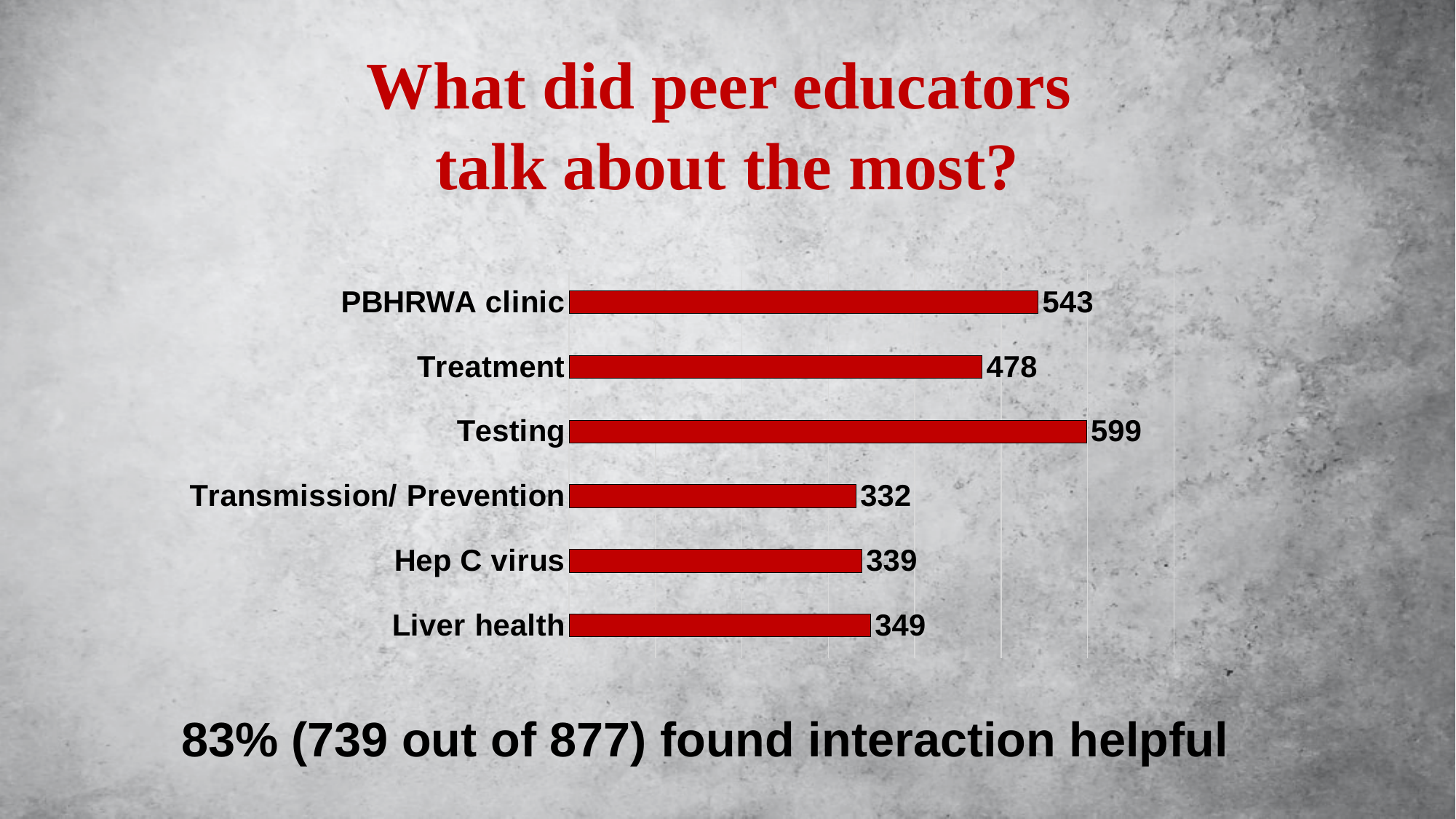
What is the difference between the values for Testing and Treatment? 121 How many categories are shown in the chart? 6 What is the value for Testing? 599 What is the difference between the values for Liver health and Hep C virus? 10 What is the value for PBHRWA clinic? 543 What kind of chart is shown on the slide? Bar chart What is the value for Transmission/ Prevention? 332 Which category has the lowest value? Transmission/ Prevention What is the value for Liver health? 349 What colour are the bars in the chart? Red Which is larger, the value for PBHRWA clinic or the value for Treatment? PBHRWA clinic Which category has the highest value? Testing